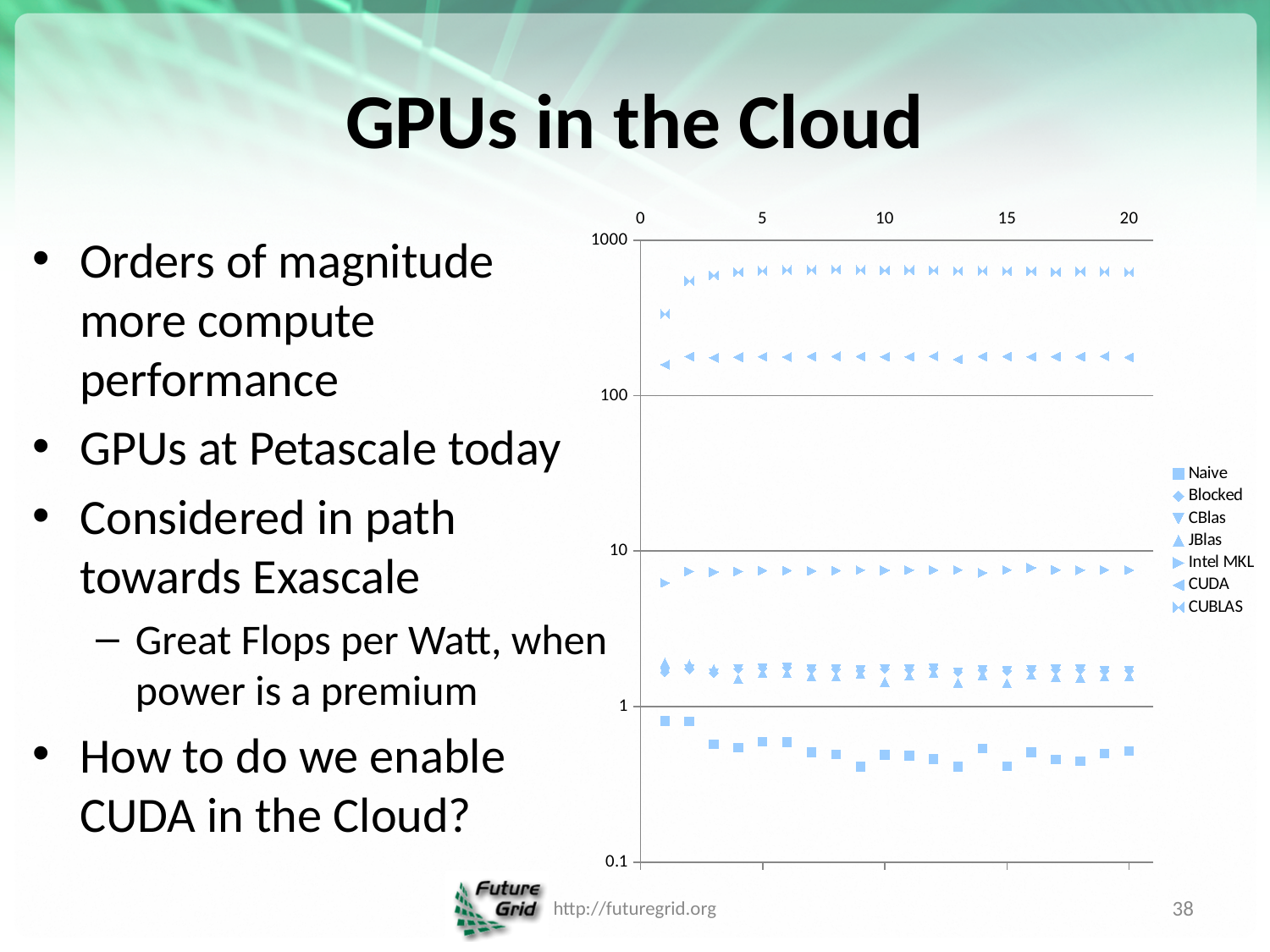
What is the highest value labelled on the y axis of the chart? 1000 Which series has larger values, Intel MKL or Naive? Intel MKL Are the values for the Naive series greater or less than 1? less Are the values for the Intel MKL series greater or less than 10? less Which series has the lowest values on the chart? Naive How many series does the chart legend list? 7 Are the values for the CUBLAS series greater or less than 100? greater Which series has larger values, CUBLAS or CUDA? CUBLAS What is the last entry listed in the chart legend? CUBLAS Which series has the highest values on the chart? CUBLAS What kind of chart is shown on the slide? scatter chart